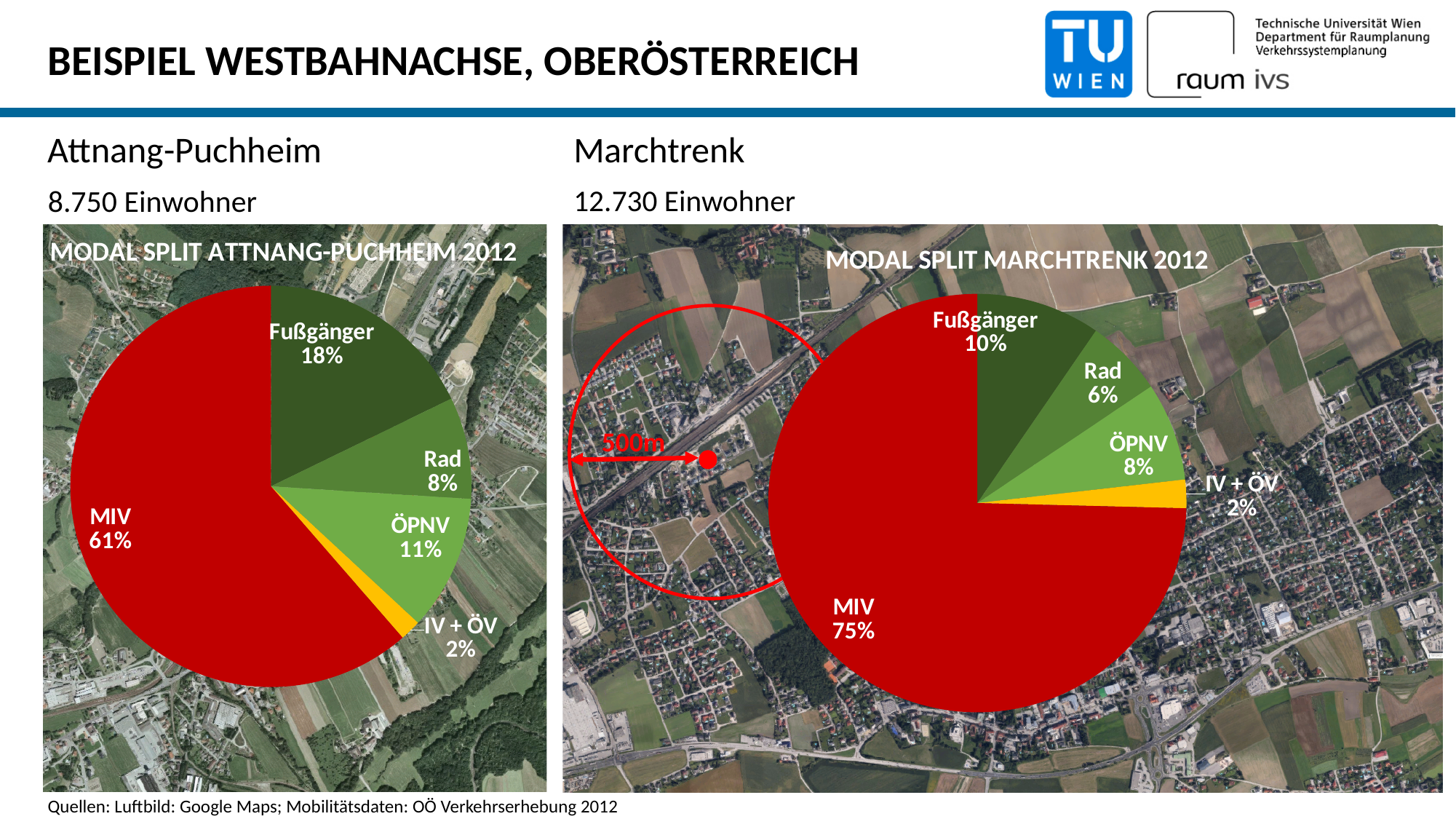
Which is larger: the ÖPNV share in the Attnang-Puchheim chart or the ÖPNV share in the Marchtrenk chart? Attnang-Puchheim In the chart titled 'MODAL SPLIT ATTNANG-PUCHHEIM 2012', what is the difference between the Fußgänger share and the Rad share? 10% In the chart titled 'MODAL SPLIT MARCHTRENK 2012', what colour is the MIV slice? Red In the chart titled 'MODAL SPLIT MARCHTRENK 2012', what share does Rad have? 6% What is the difference between the MIV share in the Marchtrenk chart and the MIV share in the Attnang-Puchheim chart? 14% In the chart titled 'MODAL SPLIT MARCHTRENK 2012', which category has the largest slice? MIV What kind of chart is 'MODAL SPLIT ATTNANG-PUCHHEIM 2012'? Pie chart In the chart titled 'MODAL SPLIT MARCHTRENK 2012', what share does Fußgänger have? 10% In the chart titled 'MODAL SPLIT ATTNANG-PUCHHEIM 2012', what share does ÖPNV have? 11% In the chart titled 'MODAL SPLIT ATTNANG-PUCHHEIM 2012', which category has the smallest slice? IV + ÖV How many categories does the chart titled 'MODAL SPLIT MARCHTRENK 2012' show? 5 In the chart titled 'MODAL SPLIT ATTNANG-PUCHHEIM 2012', what share does MIV have? 61%